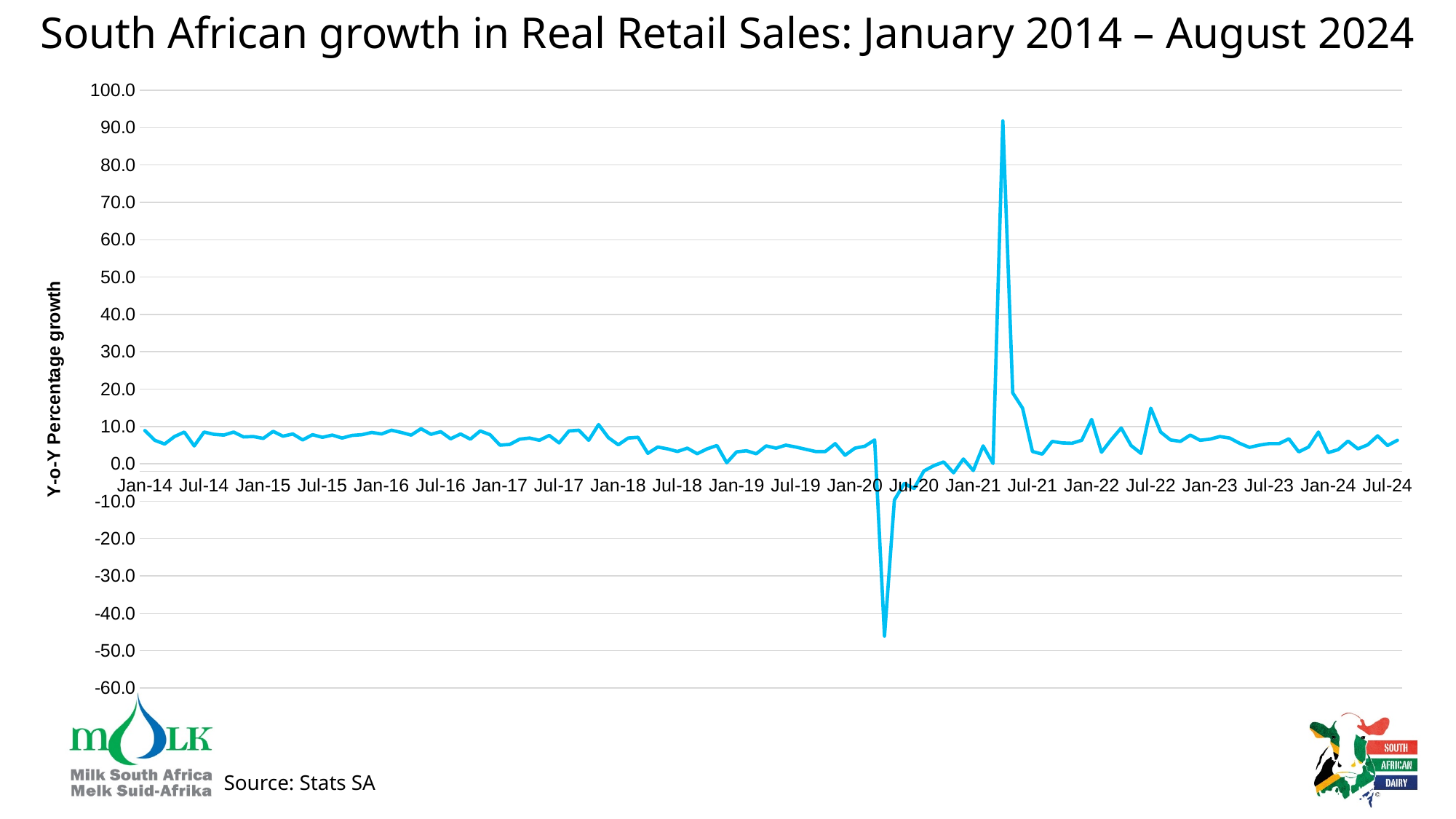
In which year does the line reach its highest point? 2021 How many lines (data series) are plotted on the chart? 1 Between Jan-20 and the low point shortly after it in 2020, does the line rise or fall? fall What is the title of the chart? South African growth in Real Retail Sales: January 2014 – August 2024 Is the value for Jul-24 greater or less than 10.0? less In which year does the line reach its lowest point? 2020 Is the lowest value on the line (the 2020 dip) greater or less than -40.0? less What kind of chart is shown on the slide? line chart What is the label on the vertical axis of the chart? Y-o-Y Percentage growth Which is higher, the value at Jan-22 or the value at Jan-19? Jan-22 Is the value for Jan-14 greater or less than 5.0? greater